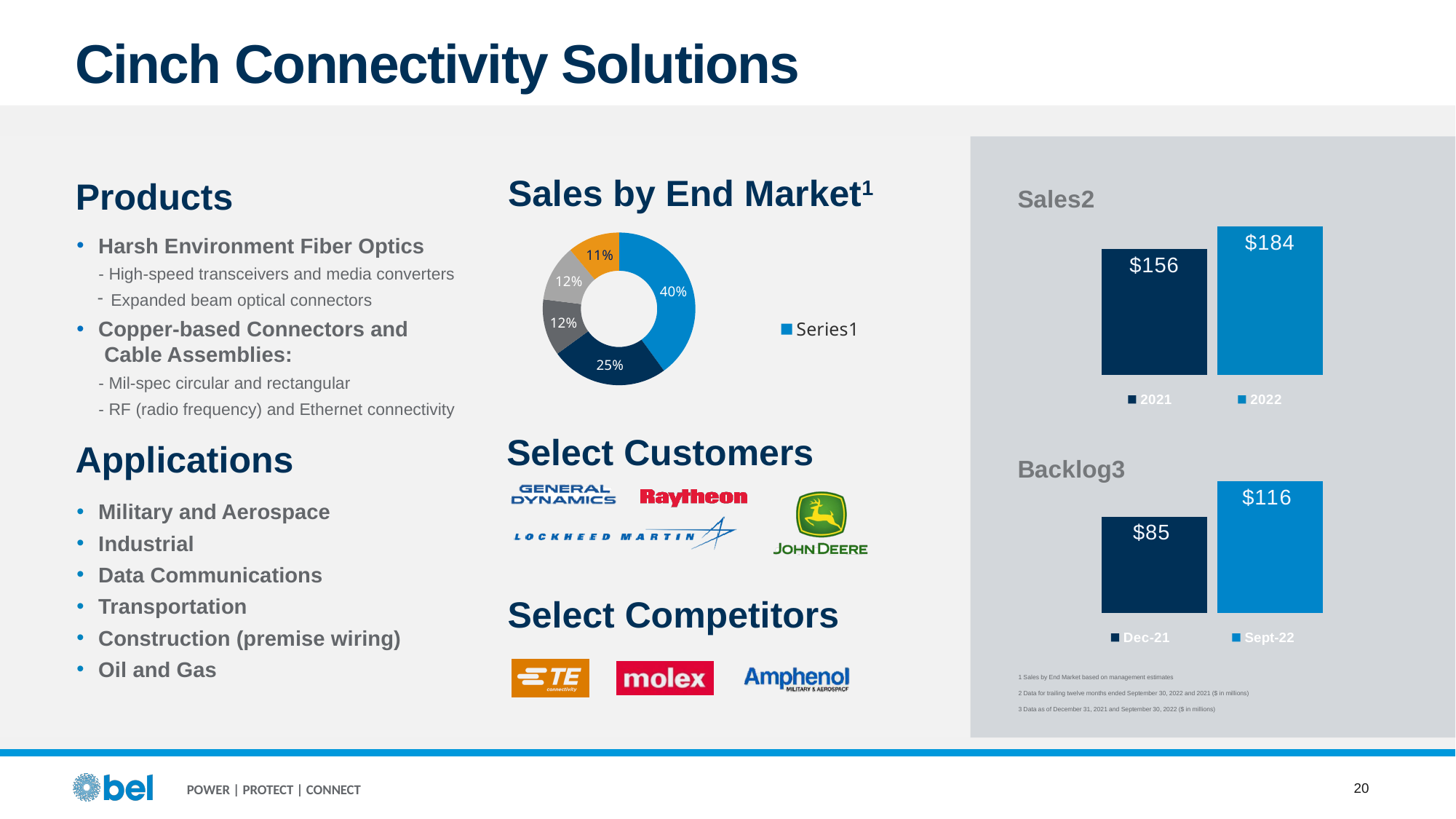
In the Backlog chart, what is the value for Dec-21? $85 In the Sales chart, what is the difference between the 2022 and 2021 values? $28 In the Sales by End Market chart, what is the smallest slice's percentage? 11% In the Sales by End Market chart, what is the largest slice's percentage? 40% In the Sales chart, do the values rise or fall from 2021 to 2022? rise In the Sales chart, what is the value for 2021? $156 What kind of chart is the Sales chart on the right side of the slide? bar chart In the Sales chart, what is the value for 2022? $184 How many slices does the Sales by End Market chart have? 5 In the Backlog chart, what is the value for Sept-22? $116 In the Backlog chart, what is the difference between the Sept-22 and Dec-21 values? $31 In the Backlog chart, which period has the higher value, Dec-21 or Sept-22? Sept-22